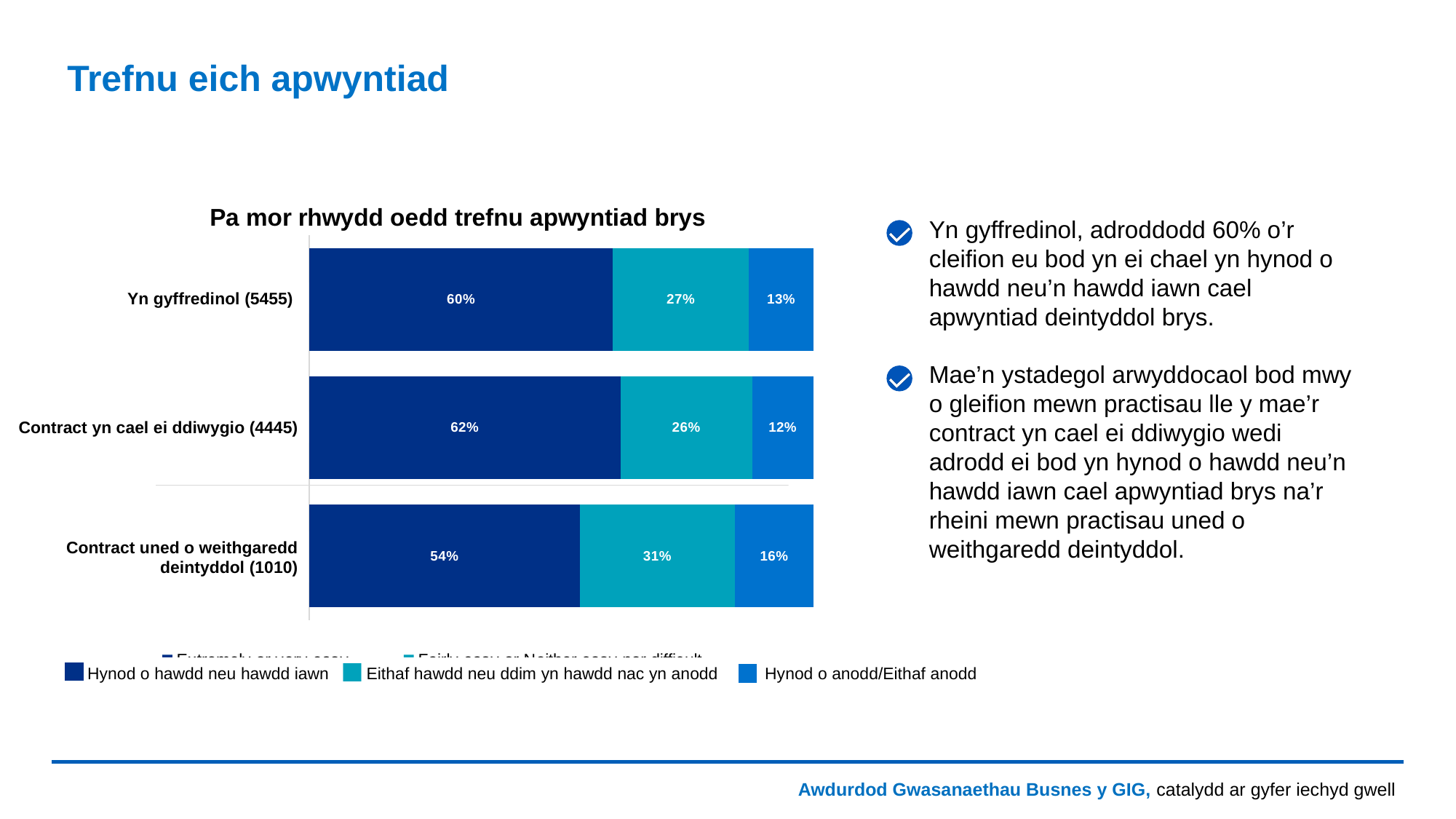
Which is larger: the 'Hynod o anodd/Eithaf anodd' share for 'Yn gyffredinol (5455)' or for 'Contract uned o weithgaredd deintyddol (1010)'? Contract uned o weithgaredd deintyddol (1010) How many series does the legend list? 3 What percentage of patients in the 'Yn gyffredinol (5455)' category reported 'Hynod o hawdd neu hawdd iawn'? 60% What is the difference in the 'Hynod o hawdd neu hawdd iawn' share between 'Contract yn cael ei ddiwygio (4445)' and 'Contract uned o weithgaredd deintyddol (1010)'? 8 percentage points What is the total of the three segments in the 'Yn gyffredinol (5455)' bar? 100% What is the 'Eithaf hawdd neu ddim yn hawdd nac yn anodd' value for 'Contract yn cael ei ddiwygio (4445)'? 26% What is the title of the chart? Pa mor rhwydd oedd trefnu apwyntiad brys Which category has the lowest 'Hynod o hawdd neu hawdd iawn' share? Contract uned o weithgaredd deintyddol (1010) Which category has the highest 'Hynod o hawdd neu hawdd iawn' share? Contract yn cael ei ddiwygio (4445) What kind of chart is shown on the slide? Stacked bar chart What is the 'Hynod o anodd/Eithaf anodd' value for 'Contract uned o weithgaredd deintyddol (1010)'? 16% How many categories are shown on the chart? 3